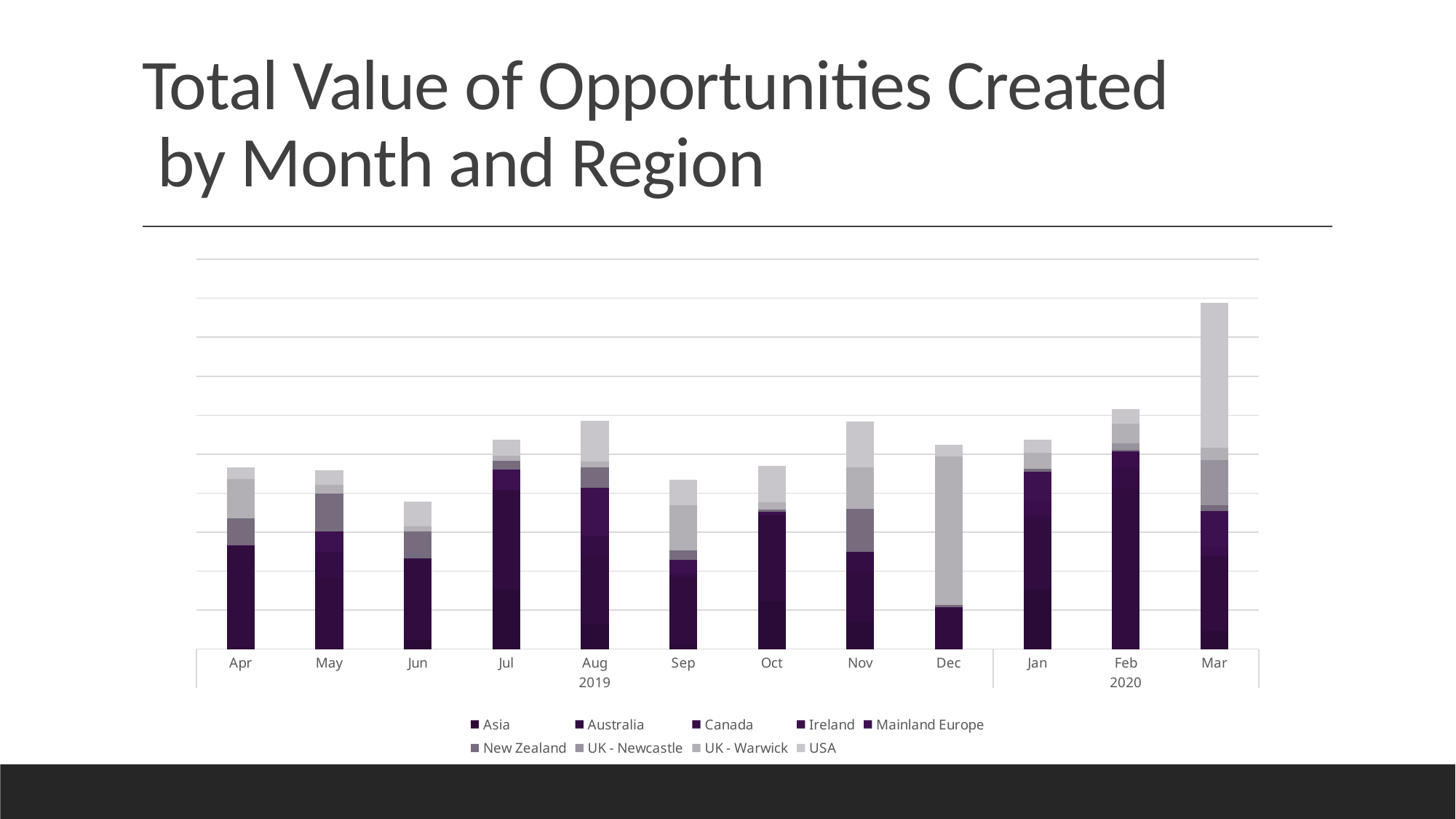
Which region is listed last in the legend? USA What is the title of the chart? Total Value of Opportunities Created by Month and Region How many regions (series) does the legend list? 9 Which month has the larger total, Mar 2020 or Feb 2020? Mar 2020 Which month has the larger total, Dec 2019 or Jun 2019? Dec 2019 Which month has the lowest total value of opportunities created? Jun 2019 How many months are shown along the x axis? 12 Which two years are labelled on the x axis? 2019 and 2020 Which month has the highest total value of opportunities created? Mar 2020 What kind of chart is shown on the slide? Stacked bar chart Which month has the larger total, Jul 2019 or Sep 2019? Jul 2019